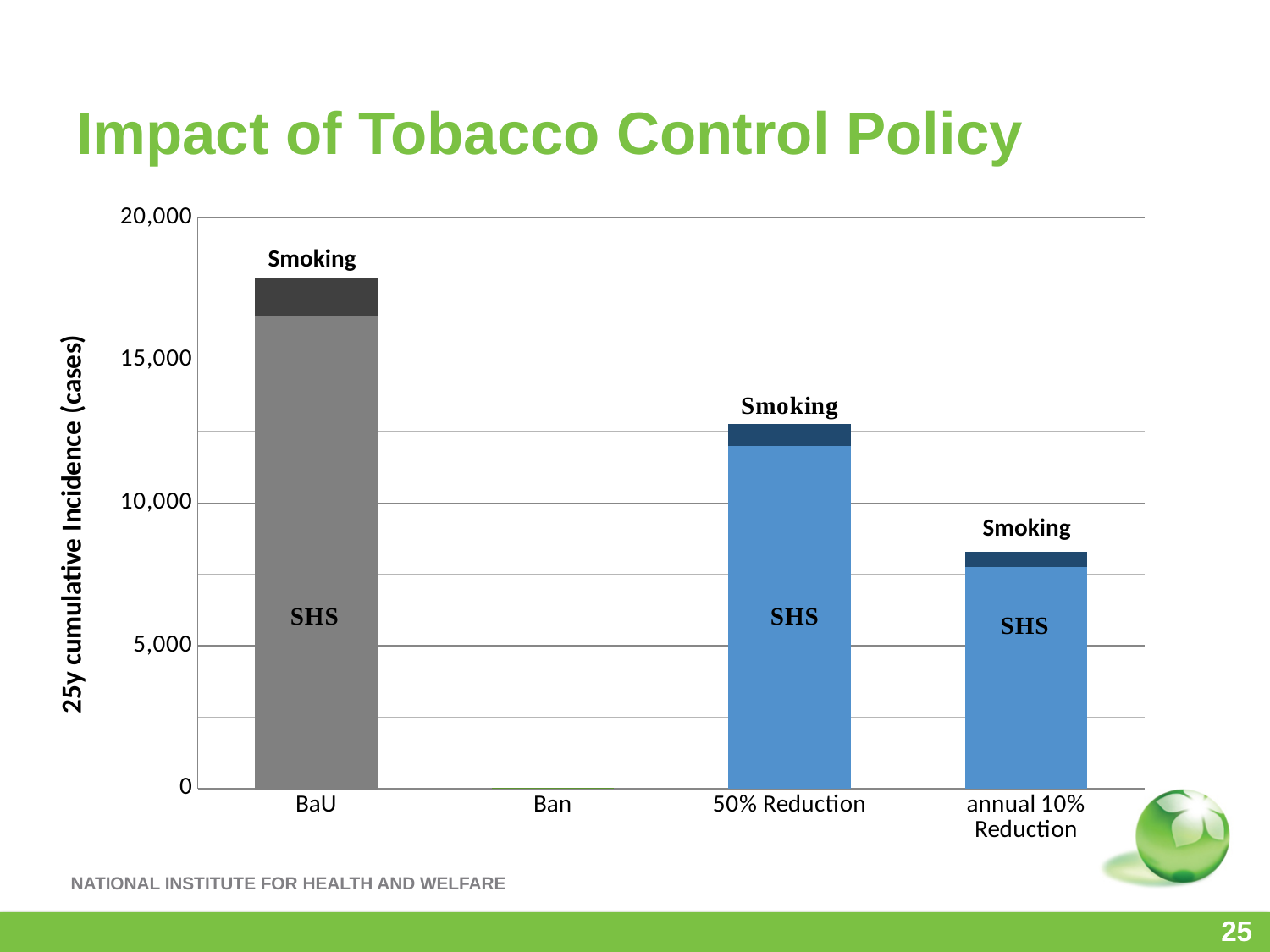
What is the title of the chart on the slide? Impact of Tobacco Control Policy Is the total bar height for BaU greater or less than 15,000? greater Is the total bar height for 50% Reduction greater or less than 10,000? greater Is the total bar height for annual 10% Reduction greater or less than 10,000? less Within each bar, which segment is larger, SHS or Smoking? SHS Which category has the tallest bar? BaU Which category shows no visible bar at all? Ban How many categories are shown along the horizontal axis? 4 What kind of chart is shown on the slide? Stacked bar chart Which bar is taller, 50% Reduction or annual 10% Reduction? 50% Reduction What is the label on the vertical axis of the chart? 25y cumulative Incidence (cases)